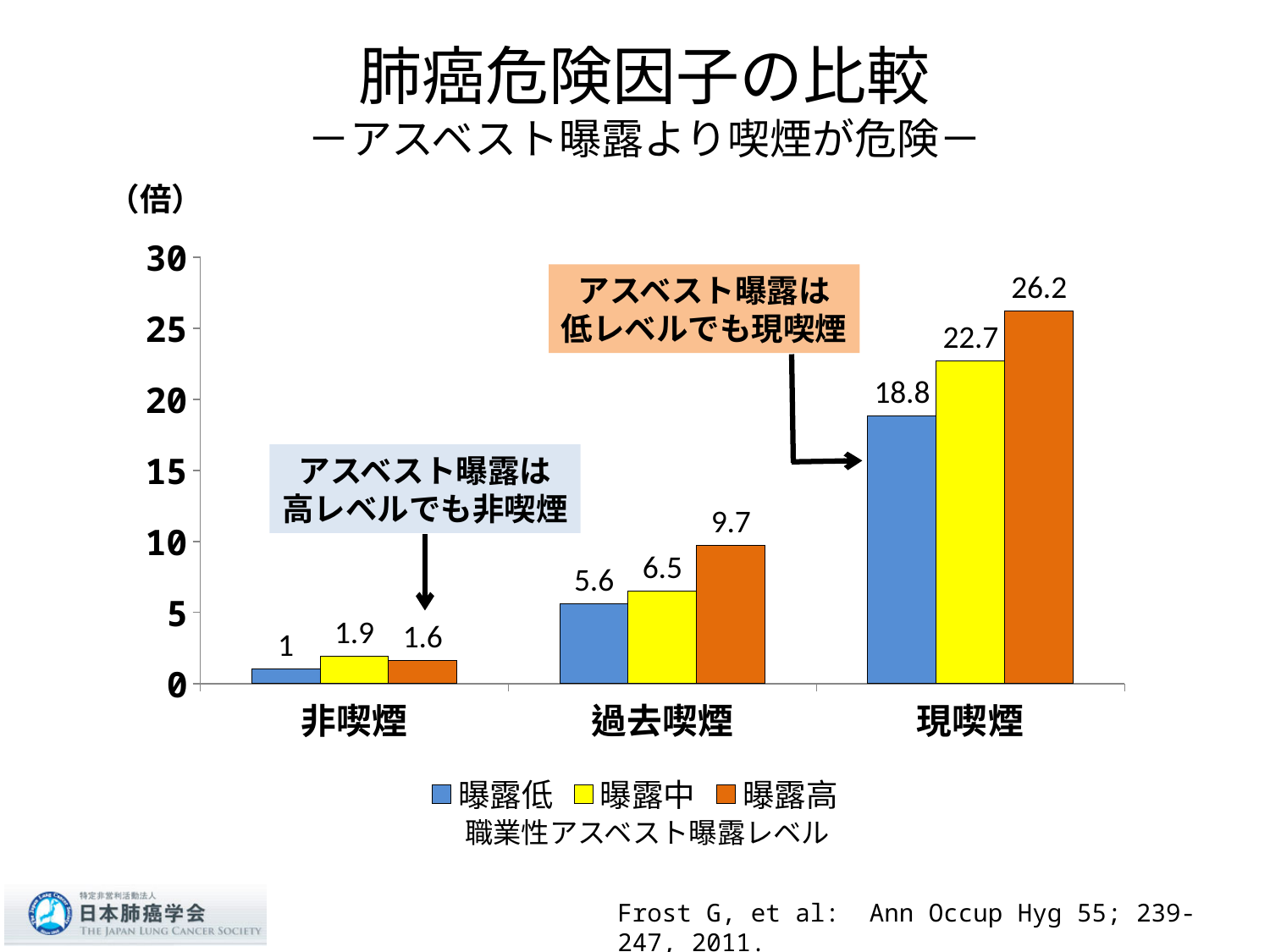
What is the value for 曝露高 in the 現喫煙 category? 26.2 What kind of chart is shown on the slide? bar chart What is the value for 曝露中 in the 非喫煙 category? 1.9 What is the difference between the 曝露高 and 曝露低 values in the 現喫煙 category? 7.4 Do the 曝露高 values rise or fall from 非喫煙 to 現喫煙? rise Which category has the lowest value for the 曝露高 series? 非喫煙 How many categories are shown on the x axis? 3 Is the value for 曝露中 in the 現喫煙 category greater or less than 20? greater What is the value for 曝露低 in the 過去喫煙 category? 5.6 Which is larger in the 非喫煙 category: 曝露中 or 曝露高? 曝露中 Which category has the highest value for the 曝露低 series? 現喫煙 How many series does the legend list? 3